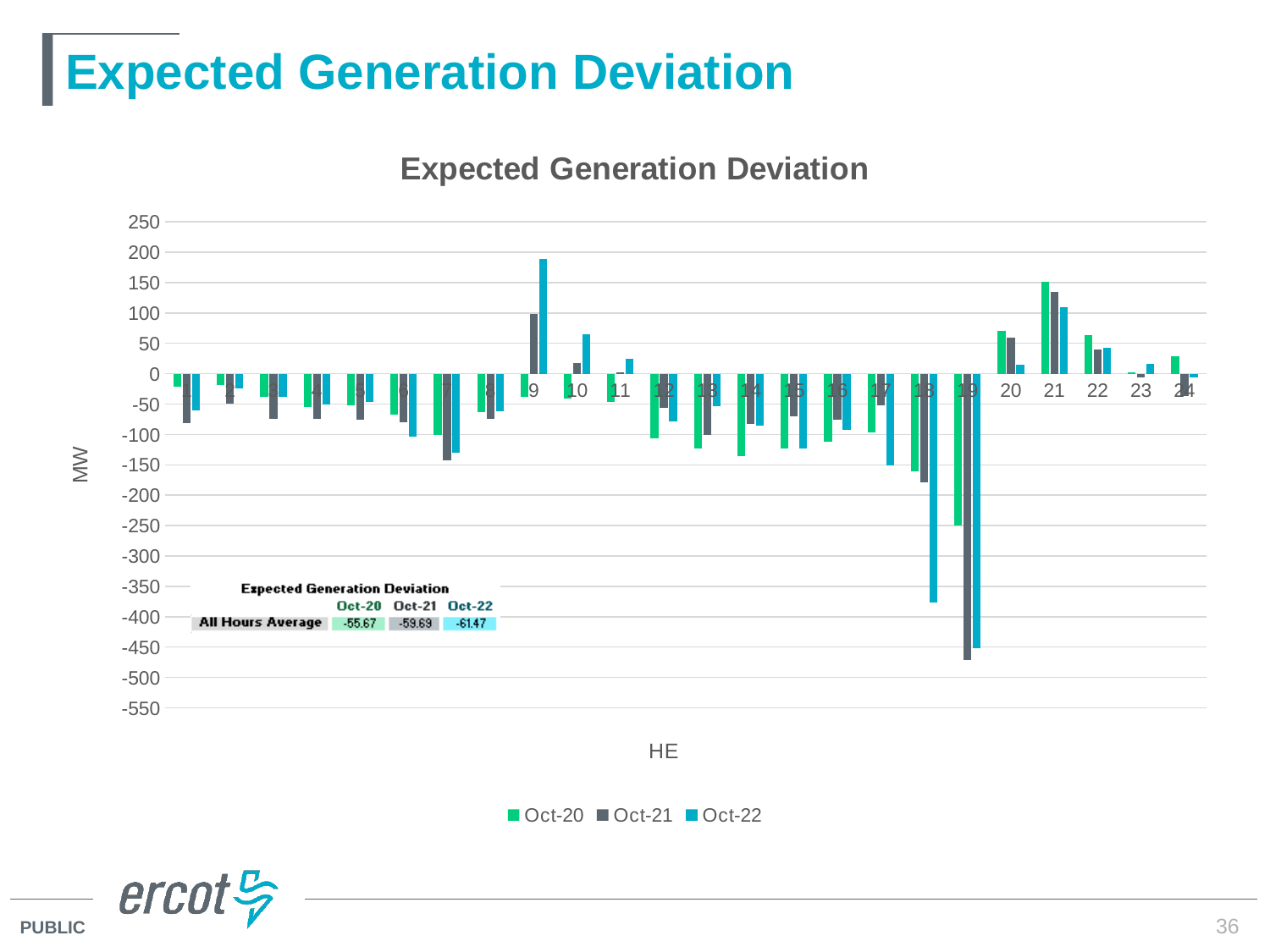
In the inset table, which has the lower All Hours Average, Oct-21 or Oct-22? Oct-22 How many series does the legend list? 3 Is the Oct-21 value at HE 19 greater or less than -400? less At which hour does the Oct-21 series reach its lowest value? 19 What is the difference between the All Hours Average for Oct-20 and Oct-22 in the inset table? 5.80 Is the Oct-22 value at HE 9 greater or less than 150? greater At which hour does the Oct-22 series reach its highest value? 9 What kind of chart is shown on the slide? bar chart According to the inset table, what is the All Hours Average for Oct-20? -55.67 According to the inset table, what is the All Hours Average for Oct-22? -61.47 What is the label on the y axis? MW How many hours (HE categories) are shown on the x axis? 24